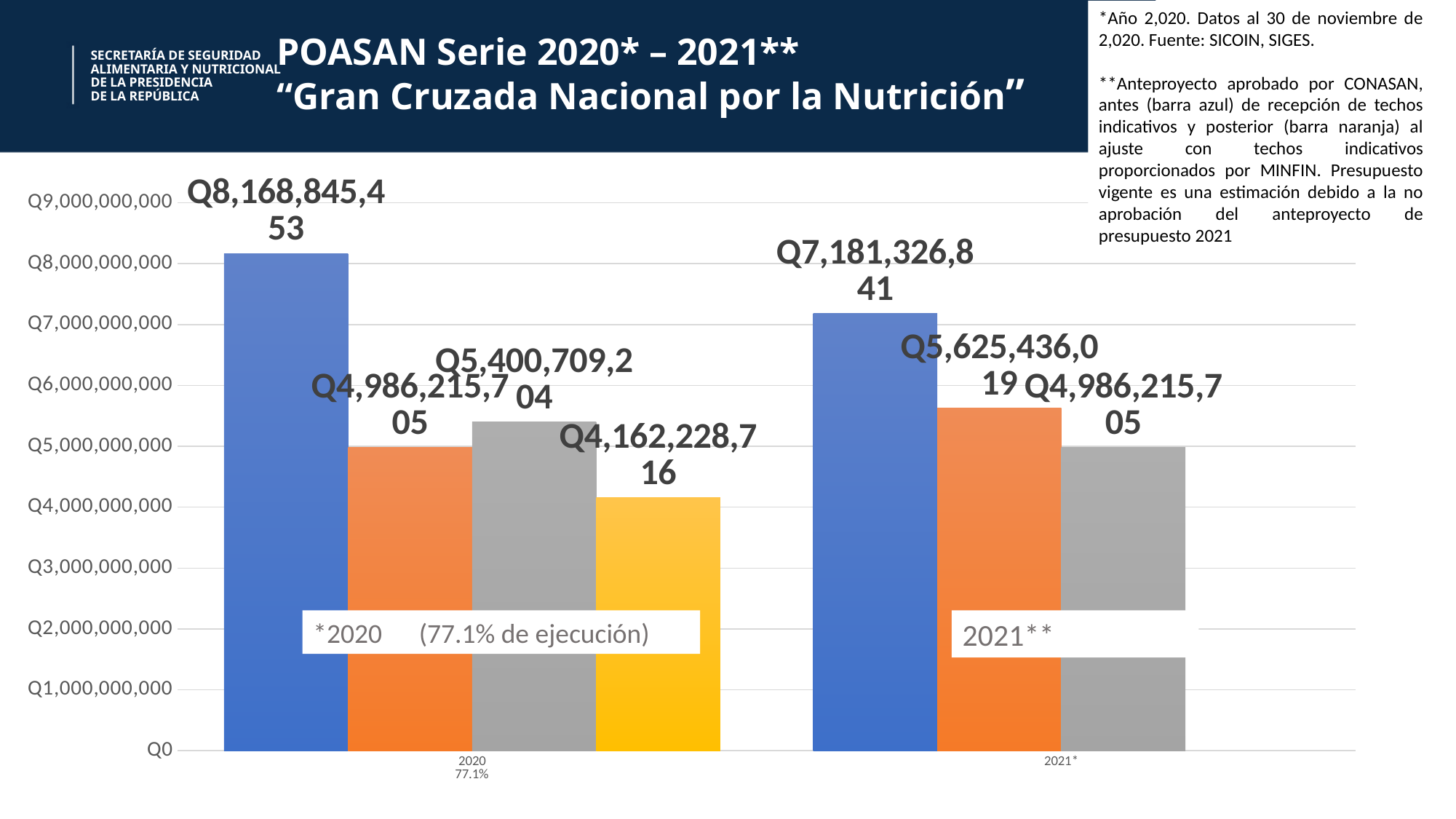
What is the value of the orange bar in the 2021 group? Q5,625,436,019 What is the difference between the blue bar for 2020 and the blue bar for 2021? Q987,518,612 What is the value of the blue bar in the 2021 group? Q7,181,326,841 How many bars are in the 2021 group? 3 What is the value of the blue bar in the 2020 group? Q8,168,845,453 Which bar in the 2020 group has the lowest value? the yellow bar (Q4,162,228,716) What execution percentage is shown for 2020 on the chart? 77.1% What is the value of the gray bar in the 2020 group? Q5,400,709,204 What kind of chart is shown on the slide? bar chart Which bar in the 2020 group has the highest value? the blue bar (Q8,168,845,453) What is the value of the yellow bar in the 2020 group? Q4,162,228,716 Which is larger: the blue bar for 2020 or the blue bar for 2021? the blue bar for 2020